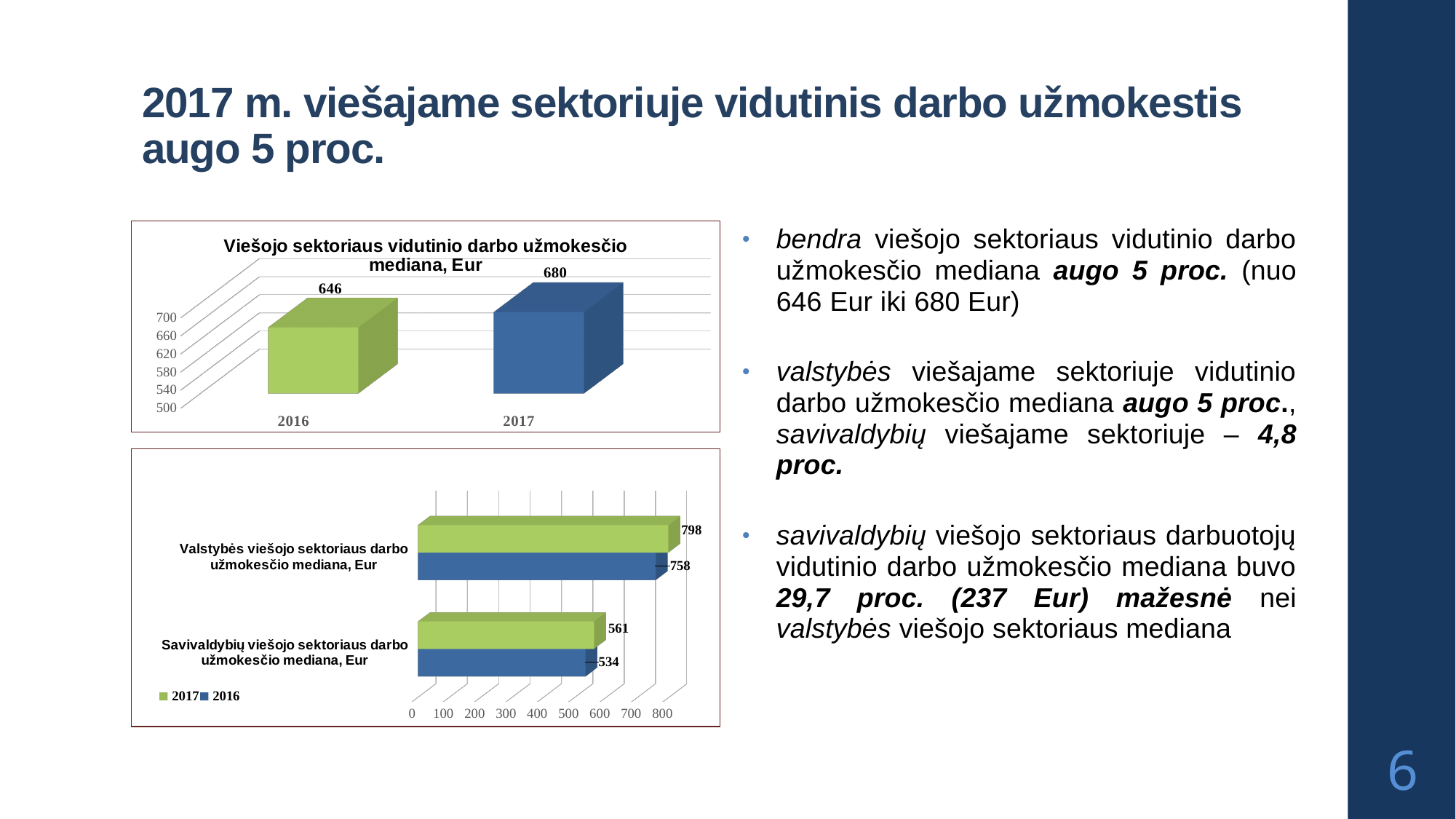
In the top chart, how many categories are shown on the x axis? 2 In the top chart 'Viešojo sektoriaus vidutinio darbo užmokesčio mediana, Eur', what is the value for 2017? 680 In the bottom chart, which is larger: the 2016 value for Valstybės or the 2017 value for Savivaldybių? 2016 value for Valstybės In the bottom chart, what is the 2017 value for 'Valstybės viešojo sektoriaus darbo užmokesčio mediana, Eur'? 798 In the top chart, what is the difference between the 2017 and 2016 values? 34 In the bottom chart, how many series does the legend list? 2 In the top chart 'Viešojo sektoriaus vidutinio darbo užmokesčio mediana, Eur', what is the value for 2016? 646 In the bottom chart, what is the 2016 value for 'Savivaldybių viešojo sektoriaus darbo užmokesčio mediana, Eur'? 534 In the bottom chart, which colour represents the 2017 series? green In the top chart, do the values rise or fall from 2016 to 2017? rise In the bottom chart, what is the difference between the 2017 and 2016 values for 'Savivaldybių viešojo sektoriaus darbo užmokesčio mediana, Eur'? 27 What kind of chart is the bottom chart? bar chart